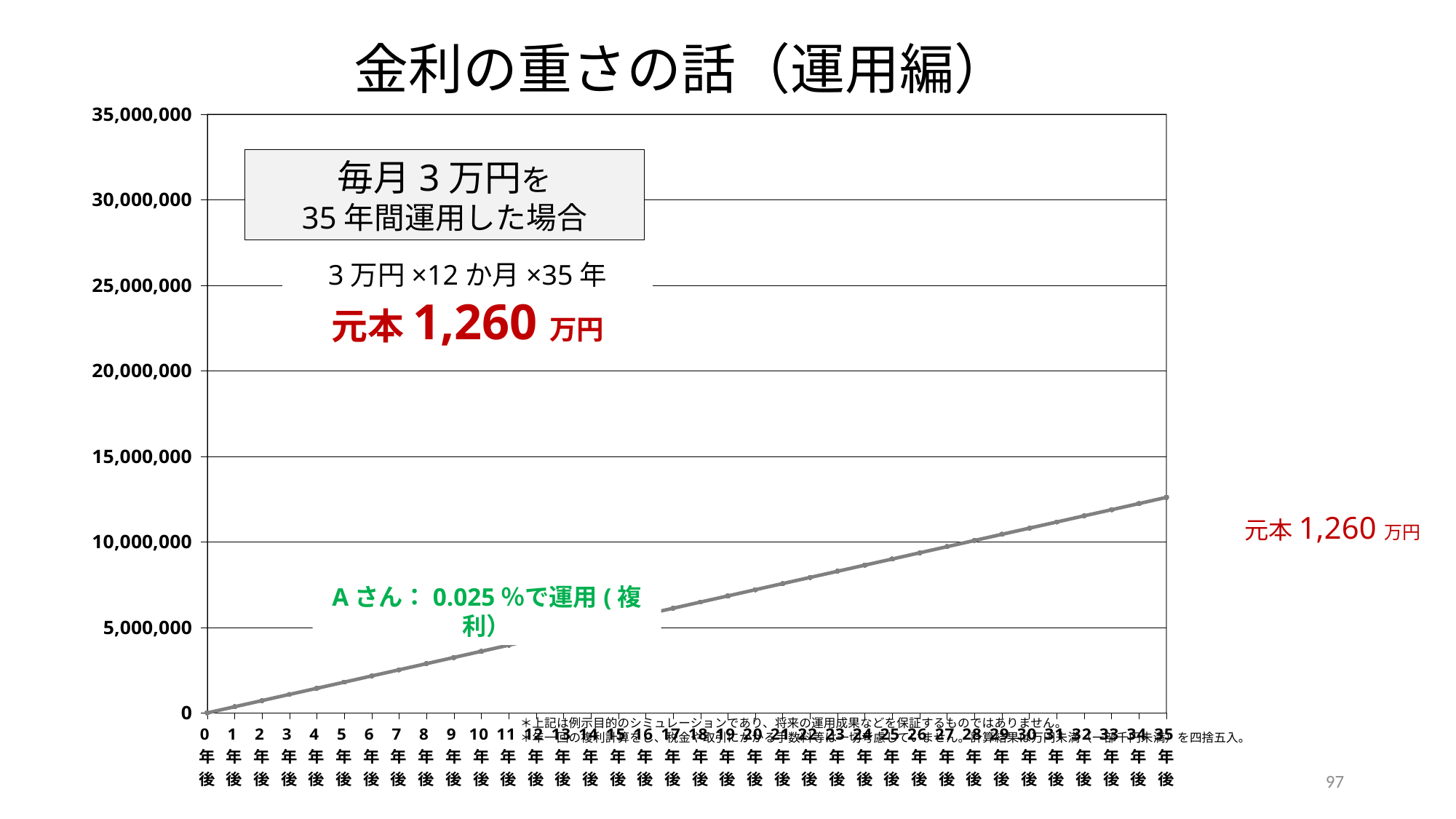
At which x-axis category is the plotted value highest? 35年後 Is the value for 10年後 greater or less than 5,000,000? less What is the highest tick value shown on the y axis? 35,000,000 What kind of chart is shown on the slide? line chart How many points (years from 0年後 to 35年後) are plotted on the x axis? 36 Is the value for 35年後 greater or less than 10,000,000? greater Is the value for 35年後 greater or less than 15,000,000? less Which has the larger plotted value, 10年後 or 20年後? 20年後 At which x-axis category is the plotted value lowest? 0年後 Do the plotted values rise or fall as the years increase along the x axis? rise What interest rate is stated for A さん's investment in the chart label? 0.025%